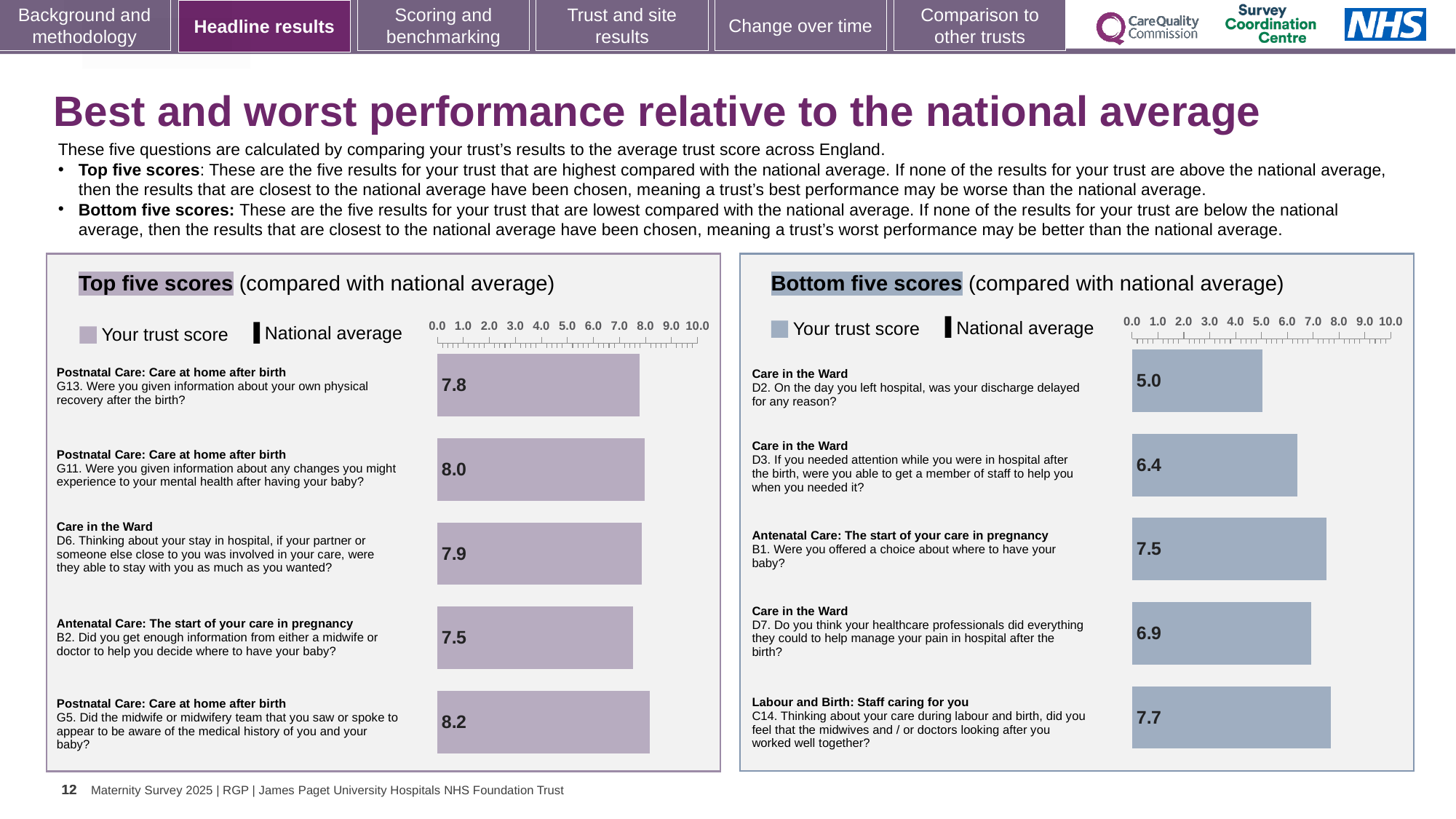
How many entries does the legend of the Top five scores chart list? 2 In the Top five scores chart, what is the difference between the trust scores for G5 and B2? 0.7 In the Top five scores chart, which question has the highest trust score? G5 In the Bottom five scores chart, which question has the lowest trust score? D2 In the Bottom five scores chart, what is the trust score for B1 (offered a choice about where to have your baby)? 7.5 In the Top five scores chart, is the trust score for D6 greater or less than 7.0? greater How many questions are shown in the Bottom five scores chart? 5 In the Bottom five scores chart, what is the difference between the trust scores for C14 and D2? 2.7 In the Bottom five scores chart, which has the larger trust score, D3 or D7? D7 What kind of chart is the Top five scores chart? Bar chart In the Bottom five scores chart, what is the trust score for D2 (was your discharge delayed for any reason)? 5.0 In the Top five scores chart, what is the trust score for G13 (information about your own physical recovery after the birth)? 7.8